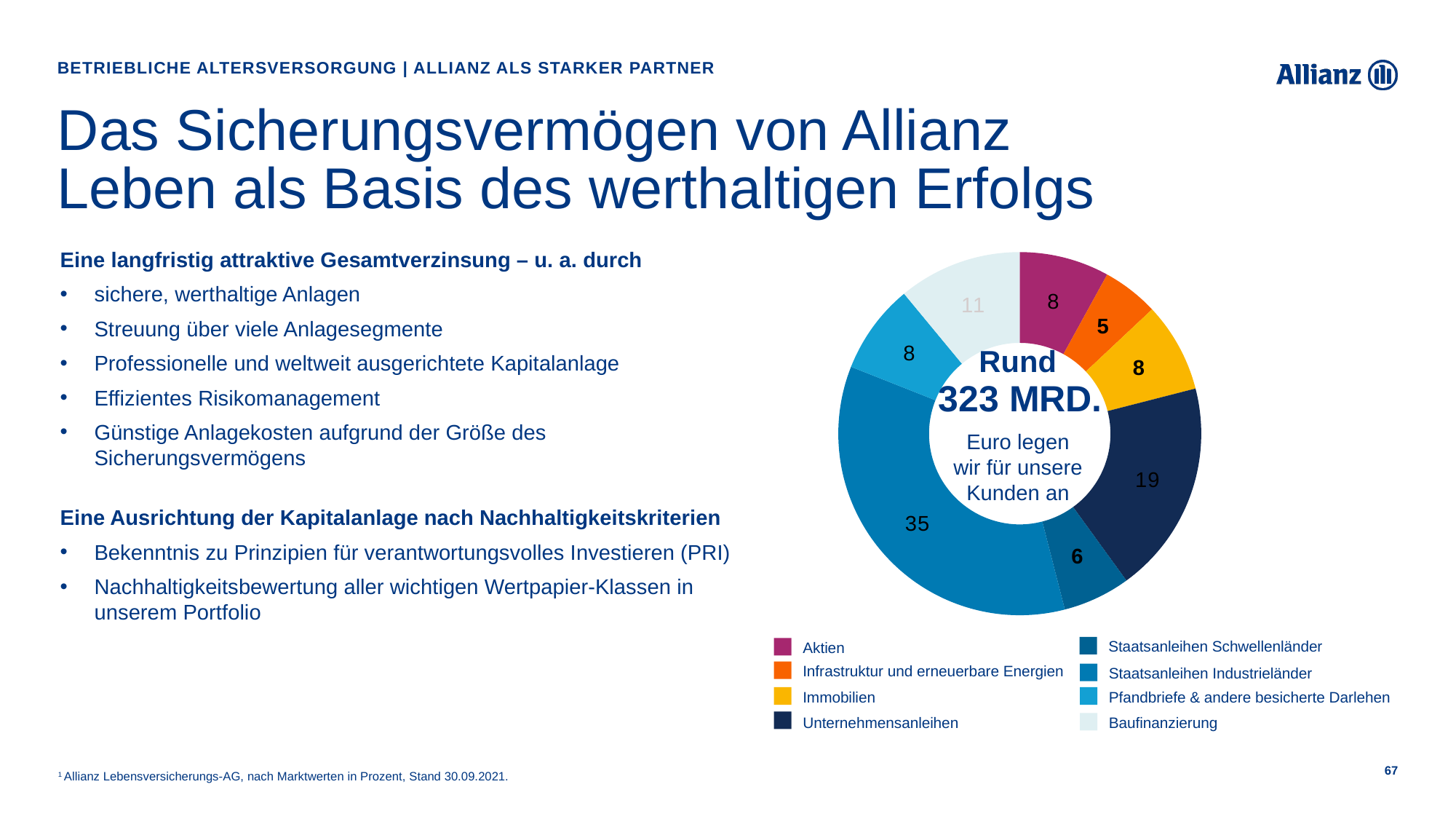
What is the value shown for Infrastruktur und erneuerbare Energien? 5 What is the value shown for Staatsanleihen Industrieländer? 35 What is the difference between the values for Staatsanleihen Industrieländer and Unternehmensanleihen? 16 What is the value shown for Unternehmensanleihen? 19 What kind of chart is shown on the slide? Donut (pie) chart Which segment has the largest value? Staatsanleihen Industrieländer What text is shown in the centre of the donut chart? Rund 323 MRD. Euro legen wir für unsere Kunden an How many segments does the donut chart have? 8 What is the value shown for Baufinanzierung? 11 What is the value shown for Staatsanleihen Schwellenländer? 6 Which segment has the smallest value? Infrastruktur und erneuerbare Energien Which is larger, the value for Baufinanzierung or the value for Immobilien? Baufinanzierung